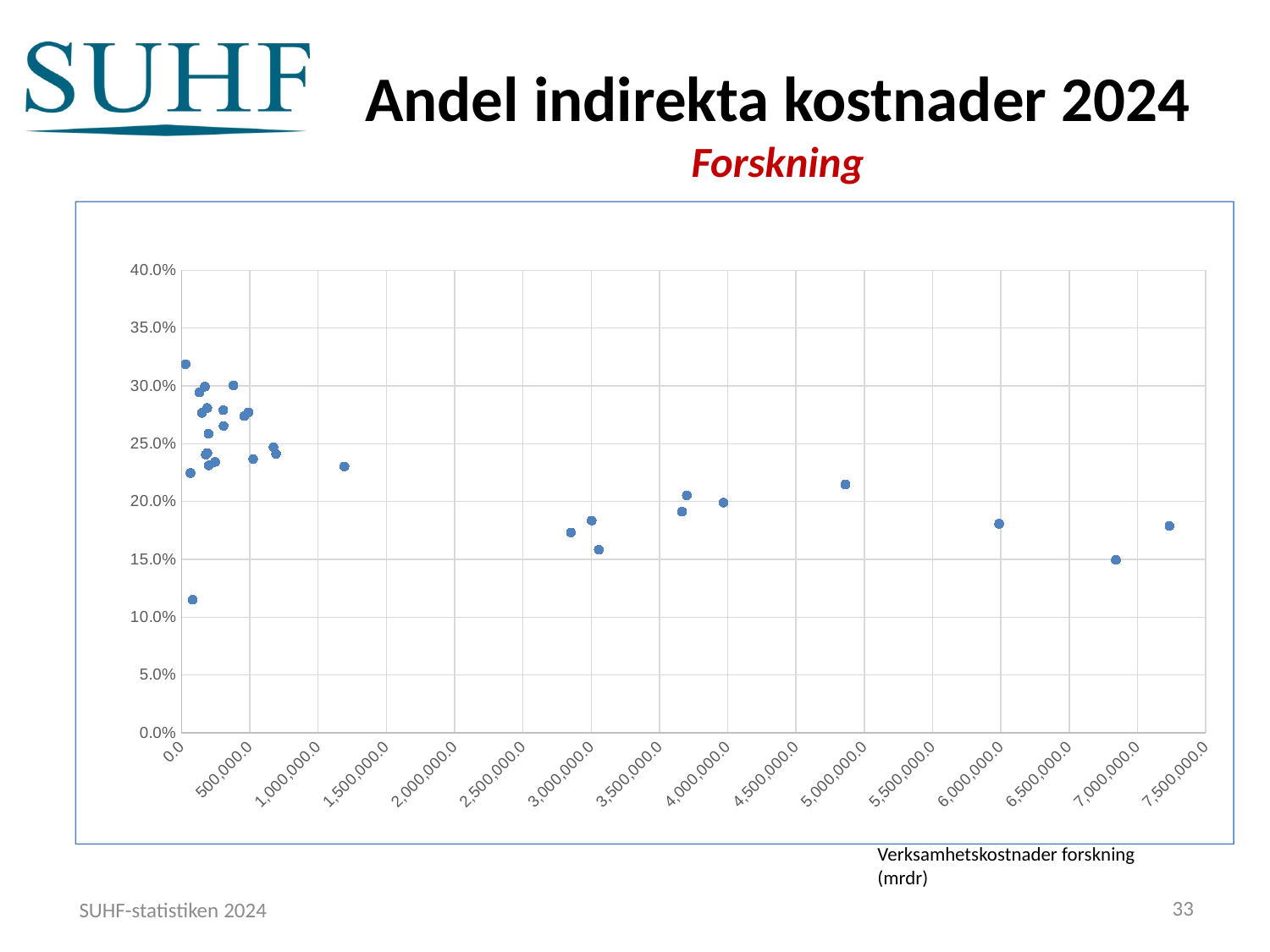
What kind of chart is shown on the slide? scatter chart Do the values generally rise or fall as the x-axis value increases? fall Is the value for the point near 6,000,000.0 on the x axis greater or less than 20.0%? less Which has the higher value: the point near 1,000,000.0 or the point near 3,000,000.0 on the x axis? the point near 1,000,000.0 What is the label of the x axis? Verksamhetskostnader forskning (mrdr) What is the title of the chart on the slide? Andel indirekta kostnader 2024 Forskning Is the highest point on the chart greater or less than 30.0%? greater Is the value for the rightmost point (near 7,500,000.0 on the x axis) greater or less than 20.0%? less Which has the higher value: the point near 5,000,000.0 or the point near 6,000,000.0 on the x axis? the point near 5,000,000.0